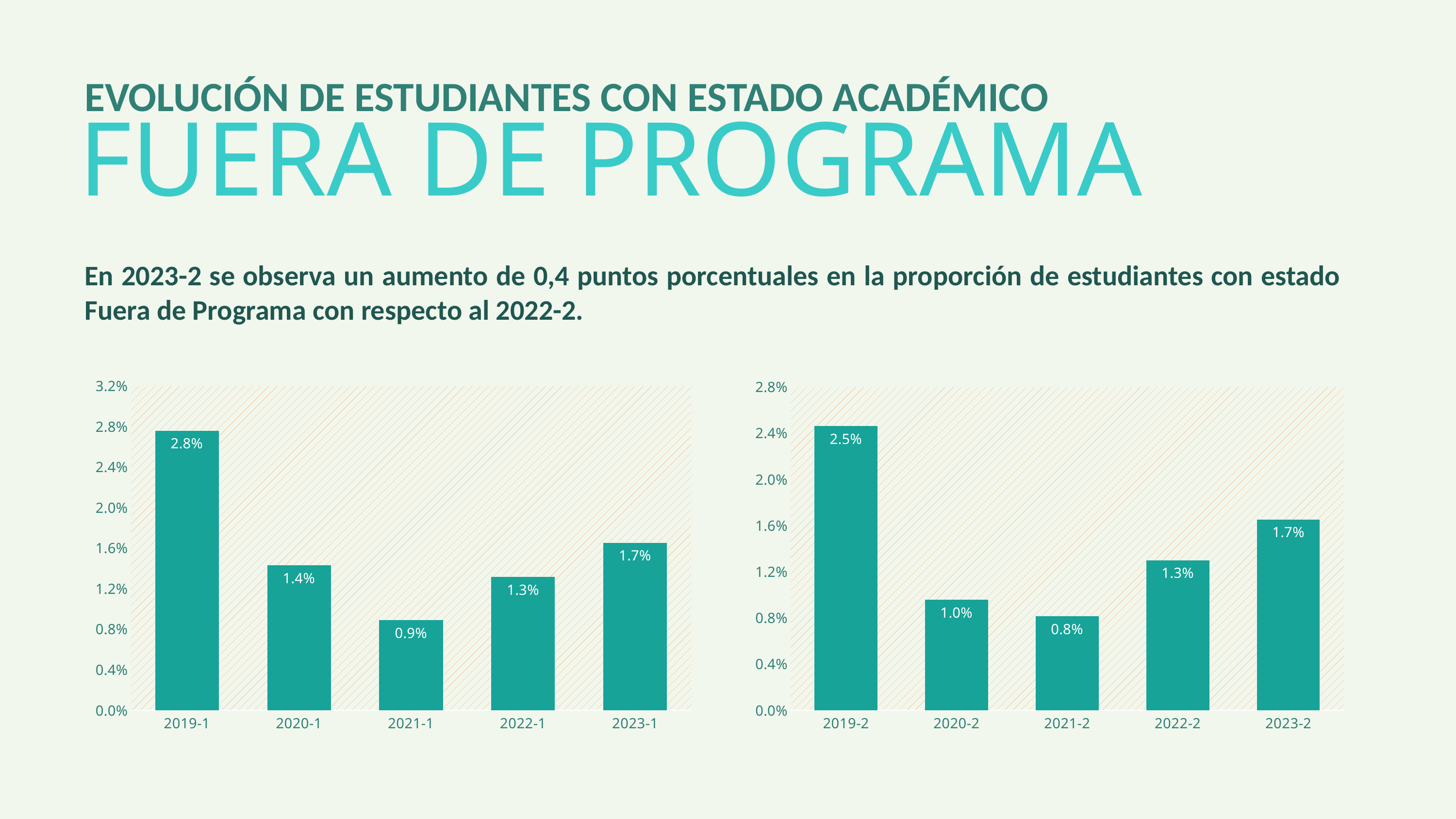
What is the highest tick shown on the y axis of the left chart? 3.2% In the right chart, do the values rise or fall from 2021-2 to 2023-2? rise In the left chart, what is the value for 2019-1? 2.8% How many periods are shown on the x axis of the left chart? 5 In the right chart, is the value for 2021-2 greater or less than 1.2%? less In the right chart, what is the value for 2022-2? 1.3% In the left chart, what is the difference between the values for 2019-1 and 2021-1? 1.9% What kind of chart is the right chart? bar chart In the left chart, which is larger, the value for 2020-1 or the value for 2022-1? 2020-1 In the left chart, which period has the lowest value? 2021-1 In the right chart, what is the difference between the values for 2023-2 and 2022-2? 0.4% In the right chart, which period has the highest value? 2019-2